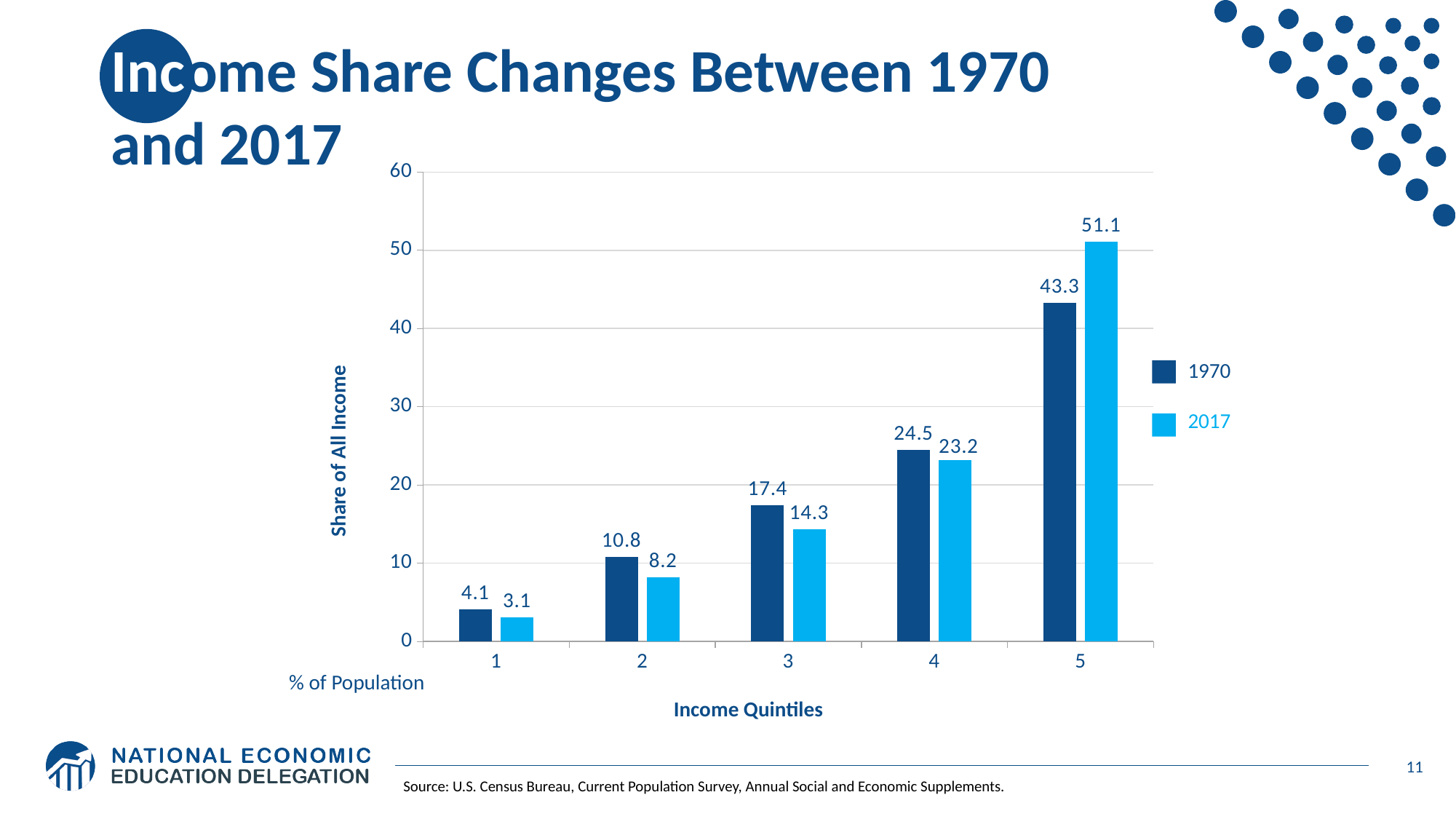
What is the difference between the 2017 and 1970 income shares for quintile 5? 7.8 How many income quintiles are shown on the x axis? 5 What is the difference between the 1970 and 2017 income shares for quintile 2? 2.6 What is the 2017 income share for quintile 1? 3.1 For quintile 4, which year has the larger income share, 1970 or 2017? 1970 What is the 1970 income share for quintile 5? 43.3 Which income quintile has the lowest 1970 income share? 1 What kind of chart is shown on the slide? bar chart How many series does the legend list? 2 Which income quintile has the highest 2017 income share? 5 What is the 2017 income share for quintile 3? 14.3 Do the 2017 income shares rise or fall from quintile 1 to quintile 5? rise